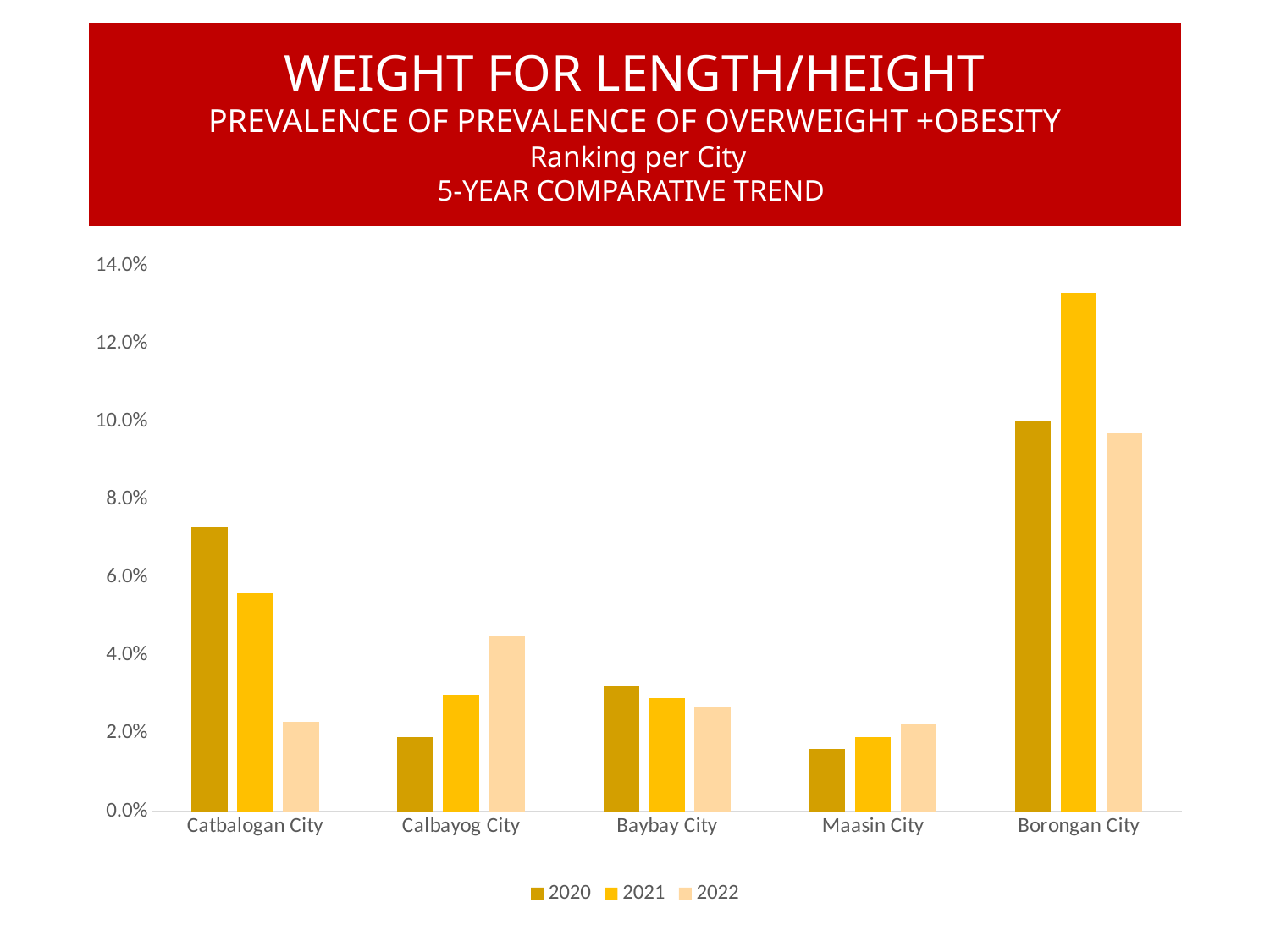
Is the 2020 value for Catbalogan City greater or less than 8.0%? less Which city has the highest value for 2021? Borongan City Do the values for Calbayog City rise or fall from 2020 to 2022? rise Which city has the lowest value for 2020? Maasin City For Catbalogan City, which is larger: the 2020 value or the 2021 value? 2020 Which years are listed in the legend? 2020, 2021, 2022 How many cities are shown on the x axis of the chart? 5 Is the 2020 value for Maasin City greater or less than 2.0%? less What kind of chart is shown on the slide? Bar chart Is the 2022 value for Calbayog City greater or less than 4.0%? greater How many series does the legend list? 3